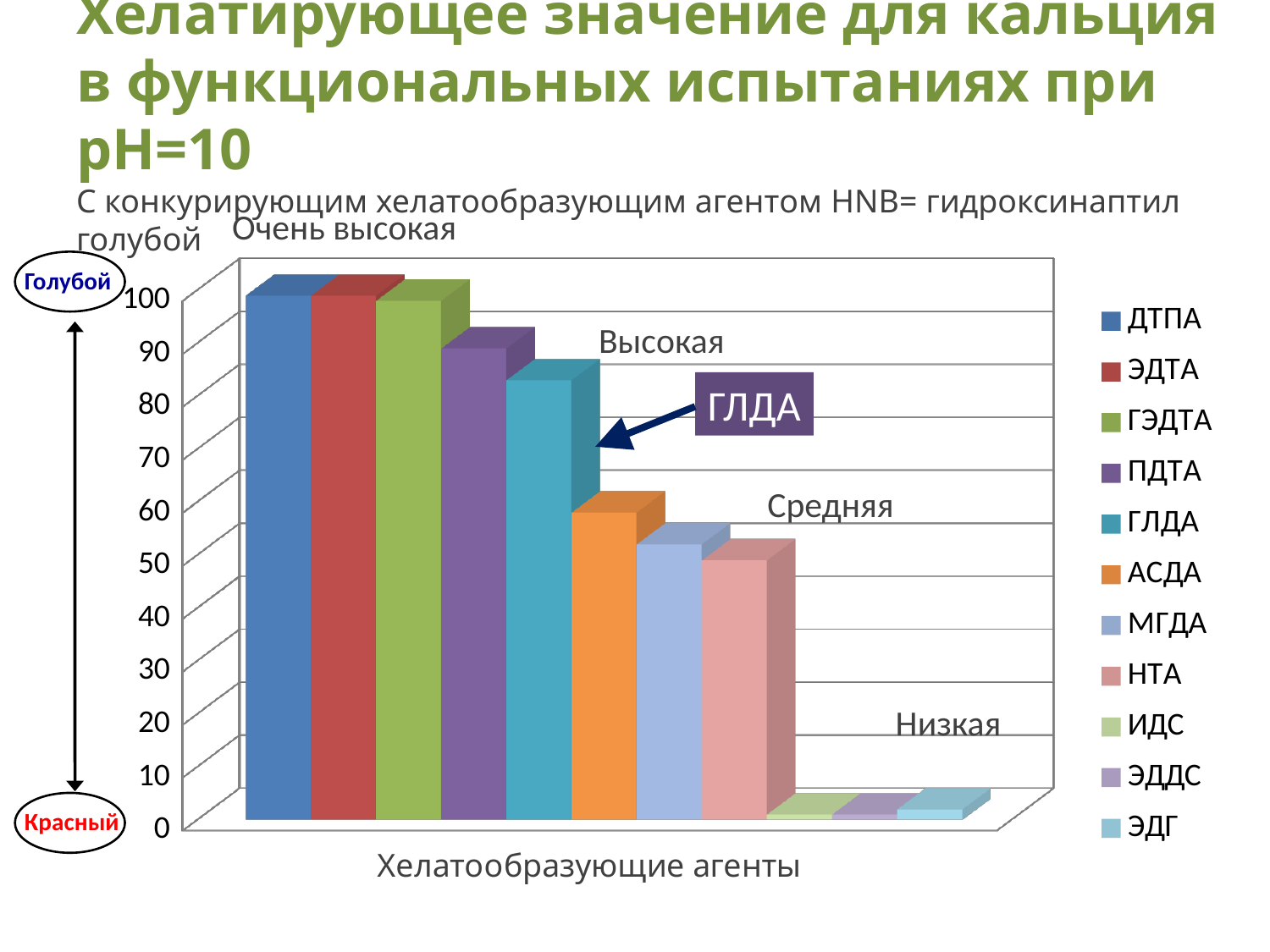
What kind of chart is shown on the slide? bar chart Is the value for ИДС greater or less than 10? less Is the value for ГЛДА greater or less than 70? greater Which is larger, the value for ПДТА or the value for АСДА? ПДТА Is the value for НТА greater or less than 60? less Which is larger, the value for МГДА or the value for ГЛДА? ГЛДА How many series does the legend list? 11 Do the bar values rise or fall from left to right across the chart? fall What is the title of the horizontal axis of the chart? Хелатообразующие агенты